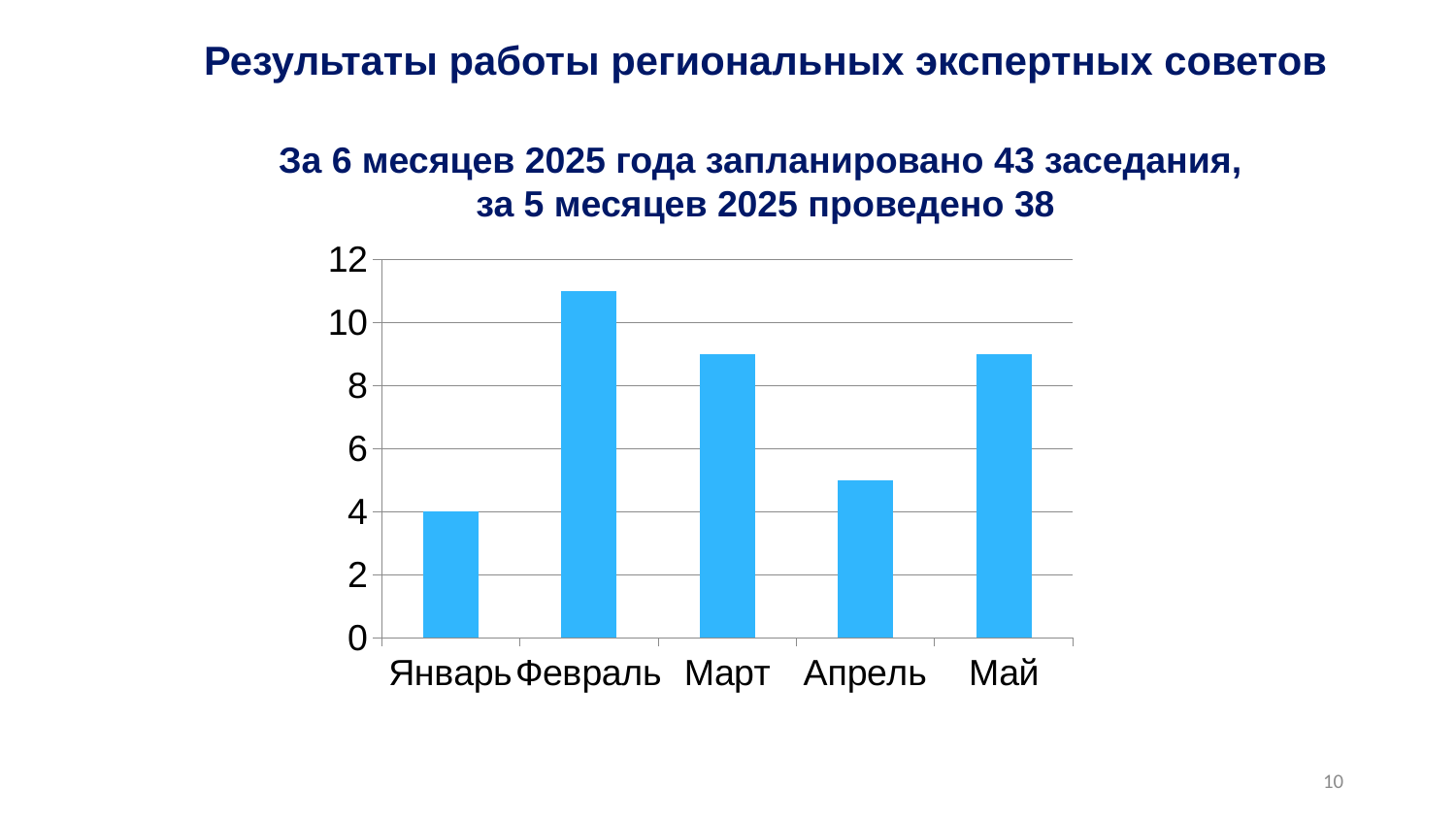
Which is larger, the value for Февраль or the value for Март? Февраль What colour are the bars in the chart? blue Which month has the lowest bar? Январь How many months are shown on the x axis? 5 Which is larger, the value for Апрель or the value for Январь? Апрель What kind of chart is shown on the slide? bar chart Is the value for Март greater or less than 8? greater Is the value for Апрель greater or less than 6? less Is the value for Февраль greater or less than 10? greater Which month has the highest bar? Февраль Does the value rise or fall from Февраль to Апрель? fall What is the value for Январь? 4